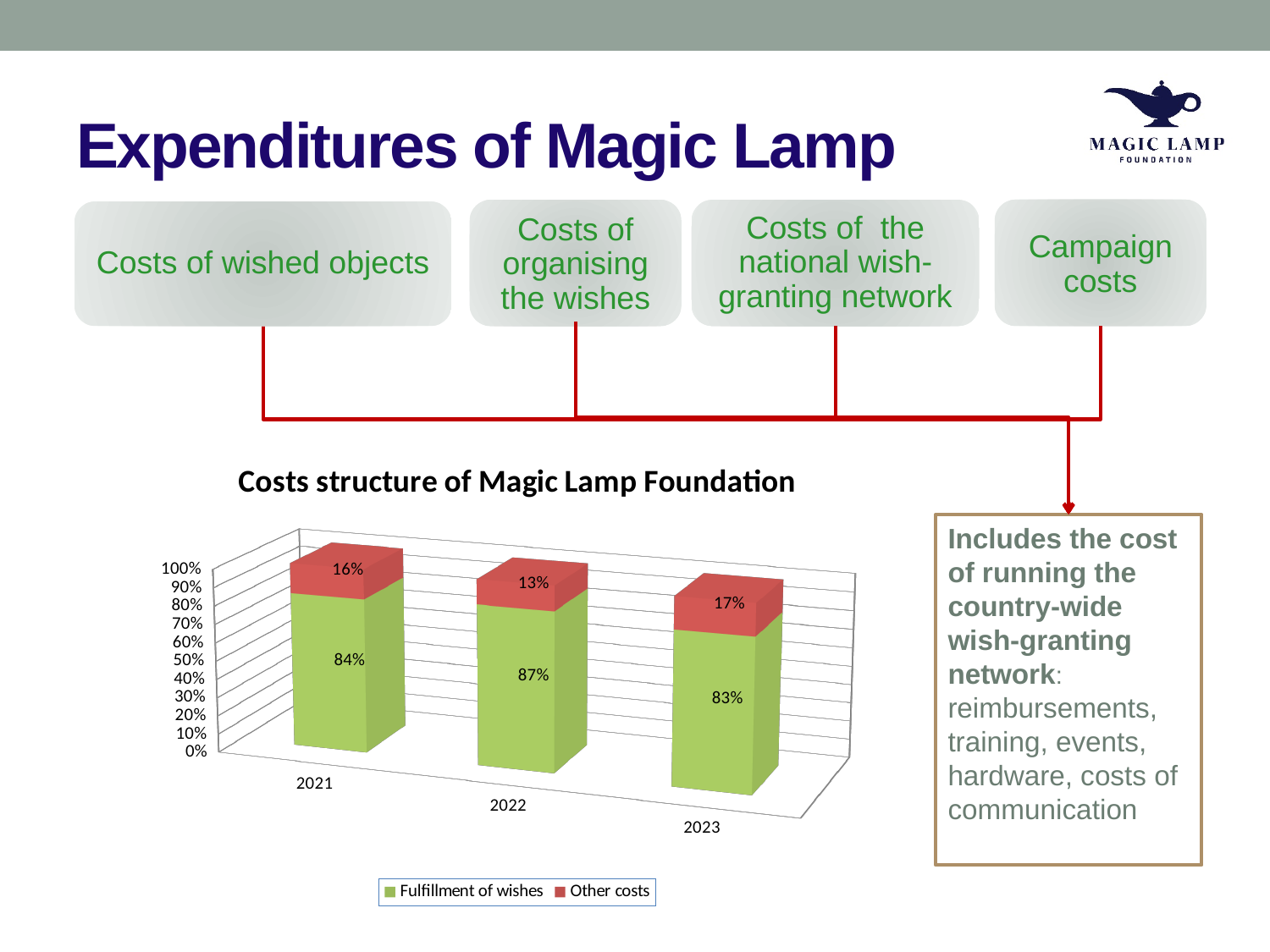
What kind of chart is shown? Stacked bar chart What is the value for Fulfillment of wishes in 2022? 87% What is the value for Fulfillment of wishes in 2021? 84% How many years are shown on the x axis? 3 How many series does the legend list? 2 Which is larger, Other costs in 2021 or Other costs in 2023? 2023 What is the title of the chart? Costs structure of Magic Lamp Foundation What is the value for Other costs in 2023? 17% Which year has the lowest value for Other costs? 2022 Which year has the highest value for Fulfillment of wishes? 2022 What is the total of the stacked bar for 2021? 100% What is the difference between the Fulfillment of wishes values for 2022 and 2023? 4%